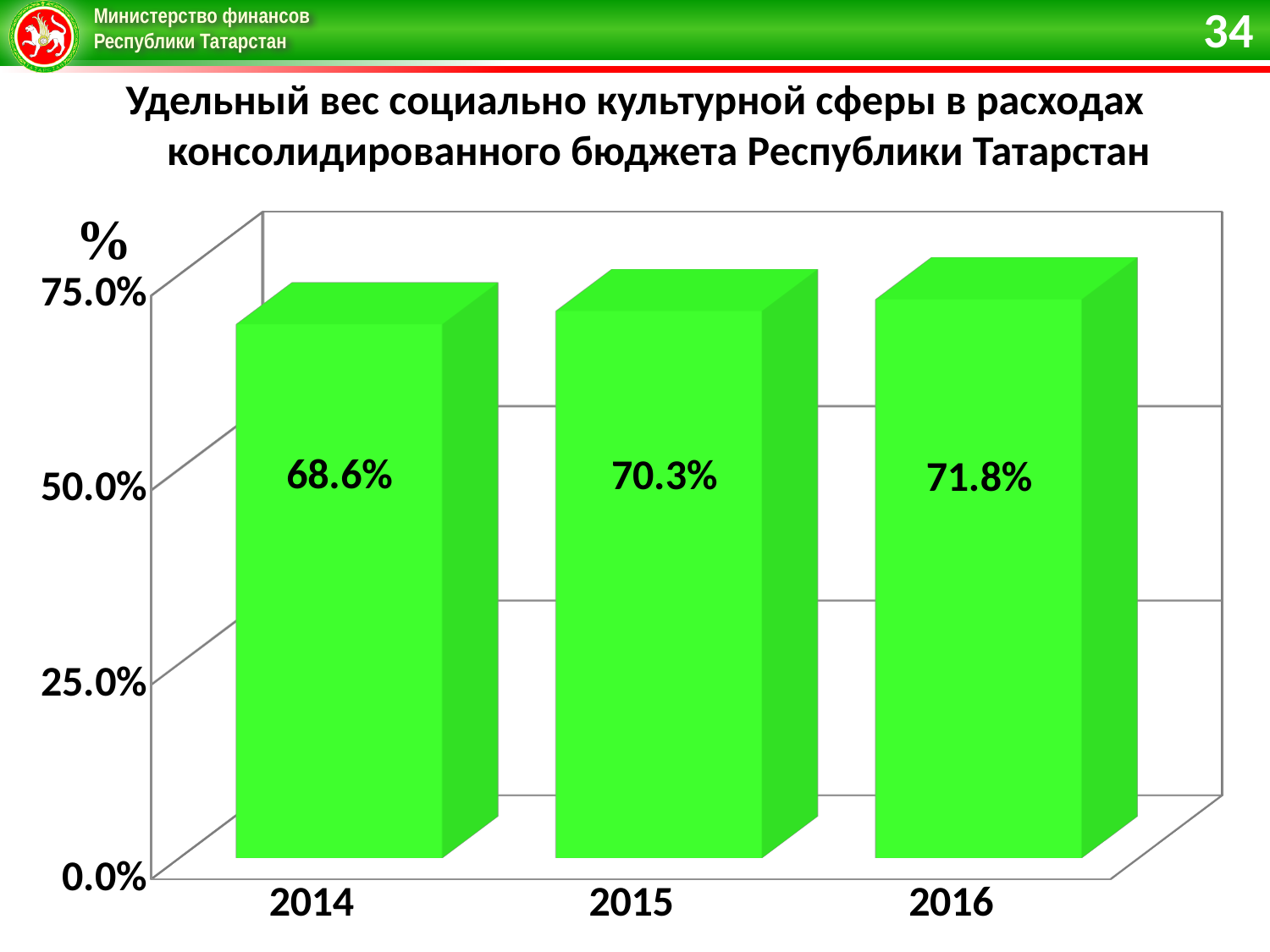
Which is larger, the value for 2015 or the value for 2016? 2016 How many years are shown on the chart? 3 What is the value for 2014? 68.6% Is the value for 2014 greater or less than 50.0%? greater What is the value for 2015? 70.3% What is the difference between the values for 2016 and 2014? 3.2% Which year has the highest value? 2016 What kind of chart is shown on the slide? bar chart Do the values rise or fall from 2014 to 2016? rise Which year has the lowest value? 2014 What is the difference between the values for 2015 and 2014? 1.7% What is the value for 2016? 71.8%